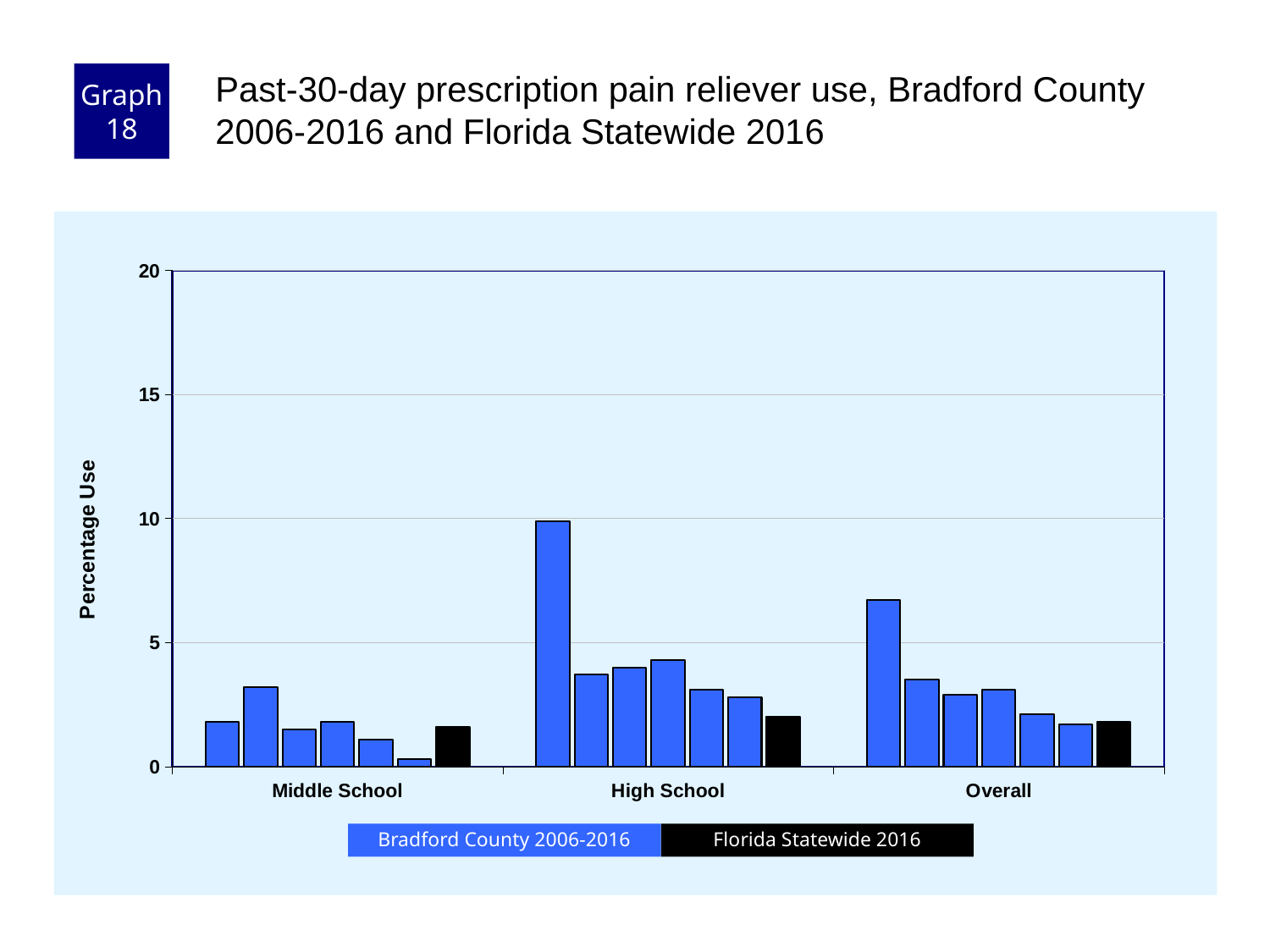
Which is larger: the tallest bar in the High School group or the tallest bar in the Overall group? High School Is the value of the tallest bar in the High School group greater or less than 15? less Which category group contains the tallest bar on the chart? High School Is the value of the tallest bar in the Overall group greater or less than 5? greater What is the label on the y axis? Percentage Use Is the value of the tallest bar in the High School group greater or less than 5? greater How many series does the legend list? 2 What kind of chart is shown on the slide? Bar chart What are the two series named in the legend? Bradford County 2006-2016 and Florida Statewide 2016 How many categories are shown on the x axis of the chart? 3